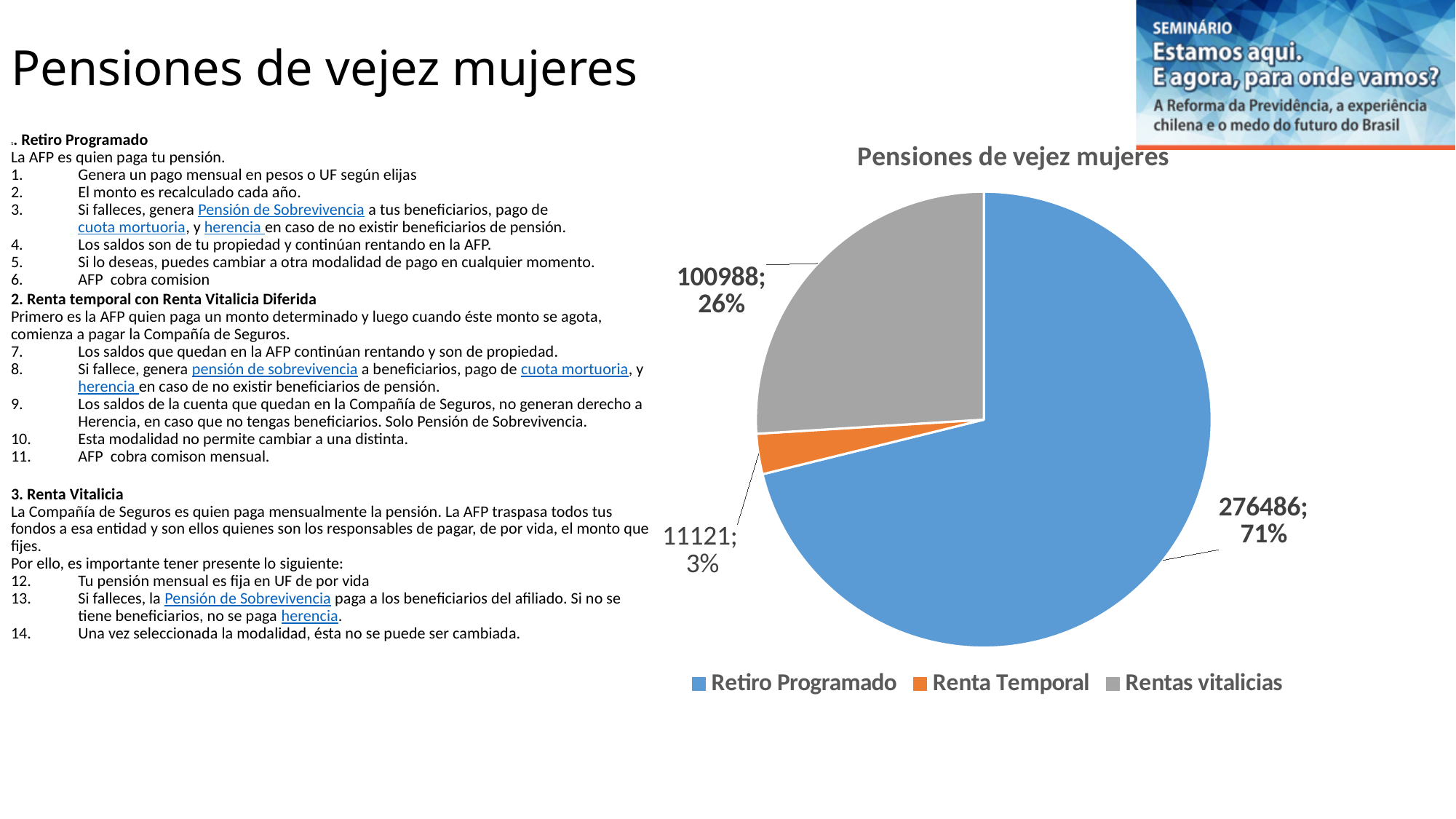
What is the difference between the values for Retiro Programado and Rentas vitalicias? 175498 How many slices does the pie chart have? 3 What is the value for Renta Temporal? 11121 How many entries does the legend list? 3 Which category has the smallest slice? Renta Temporal What is the value for Rentas vitalicias? 100988 What is the value for Retiro Programado? 276486 What kind of chart is shown on the slide? Pie chart What share of the pie does Rentas vitalicias represent? 26% What share of the pie does Retiro Programado represent? 71% Which category has the largest slice? Retiro Programado What is the title of the chart? Pensiones de vejez mujeres